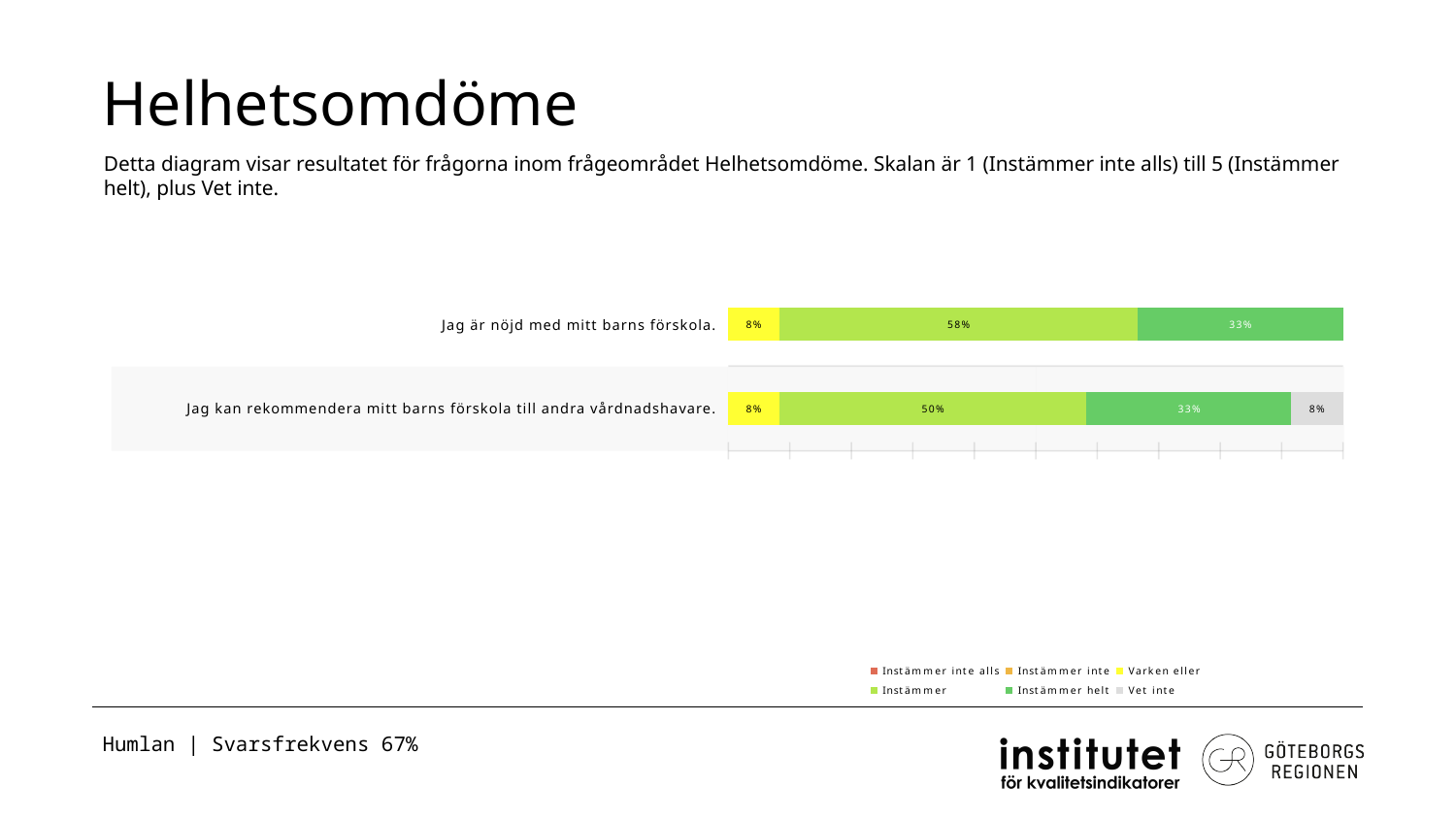
What kind of chart is shown on the slide? Stacked bar chart Which segment is the largest in the bar for 'Jag kan rekommendera mitt barns förskola till andra vårdnadshavare.'? Instämmer What is the 'Instämmer' value for 'Jag kan rekommendera mitt barns förskola till andra vårdnadshavare.'? 50% What is the title of the slide containing the chart? Helhetsomdöme Which statement has the higher 'Instämmer' value? Jag är nöjd med mitt barns förskola. What is the 'Varken eller' value for 'Jag är nöjd med mitt barns förskola.'? 8% What is the 'Instämmer helt' value for 'Jag är nöjd med mitt barns förskola.'? 33% How many categories (statements) are plotted in the chart? 2 How many series does the legend list? 6 What is the difference between the 'Instämmer' values of the two statements? 8% What is the 'Instämmer' value for 'Jag är nöjd med mitt barns förskola.'? 58% What is the 'Vet inte' value for 'Jag kan rekommendera mitt barns förskola till andra vårdnadshavare.'? 8%